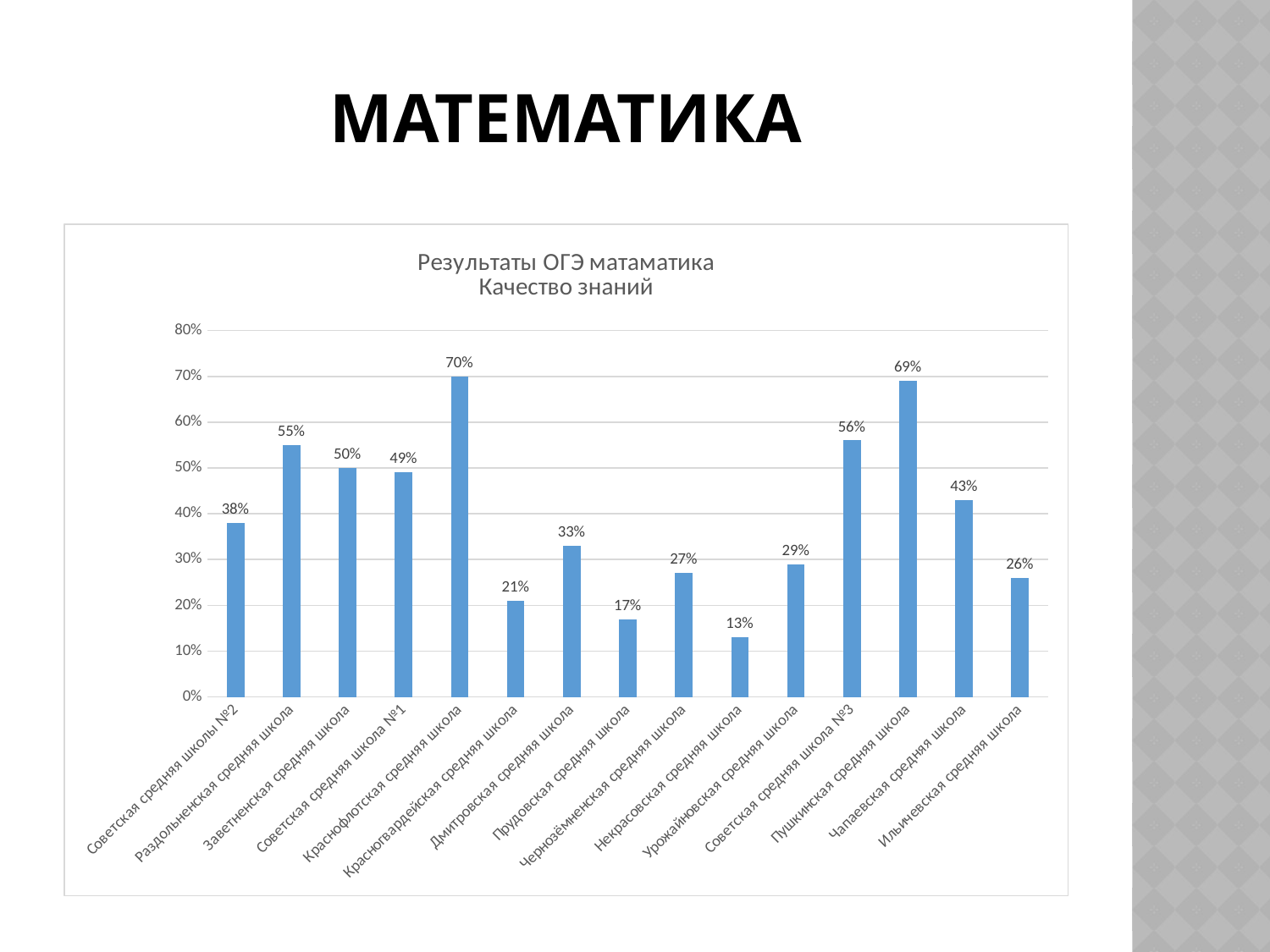
What is the value for Краснофлотская средняя школа? 70% Which school has the lowest value? Некрасовская средняя школа What is the value for Некрасовская средняя школа? 13% What is the difference between the values for Пушкинская средняя школа and Ильичевская средняя школа? 43% Is the value for Дмитровская средняя школа greater or less than 40%? less Which school has the highest value? Краснофлотская средняя школа What is the value for Чапаевская средняя школа? 43% Which is larger, the value for Раздольненская средняя школа or Советская средняя школа №3? Советская средняя школа №3 What is the title of the chart? Результаты ОГЭ матаматика Качество знаний What type of chart is shown on the slide? bar chart How many schools are shown on the x axis? 15 What is the difference between the values for Советская средняя школы №2 and Прудовская средняя школа? 21%